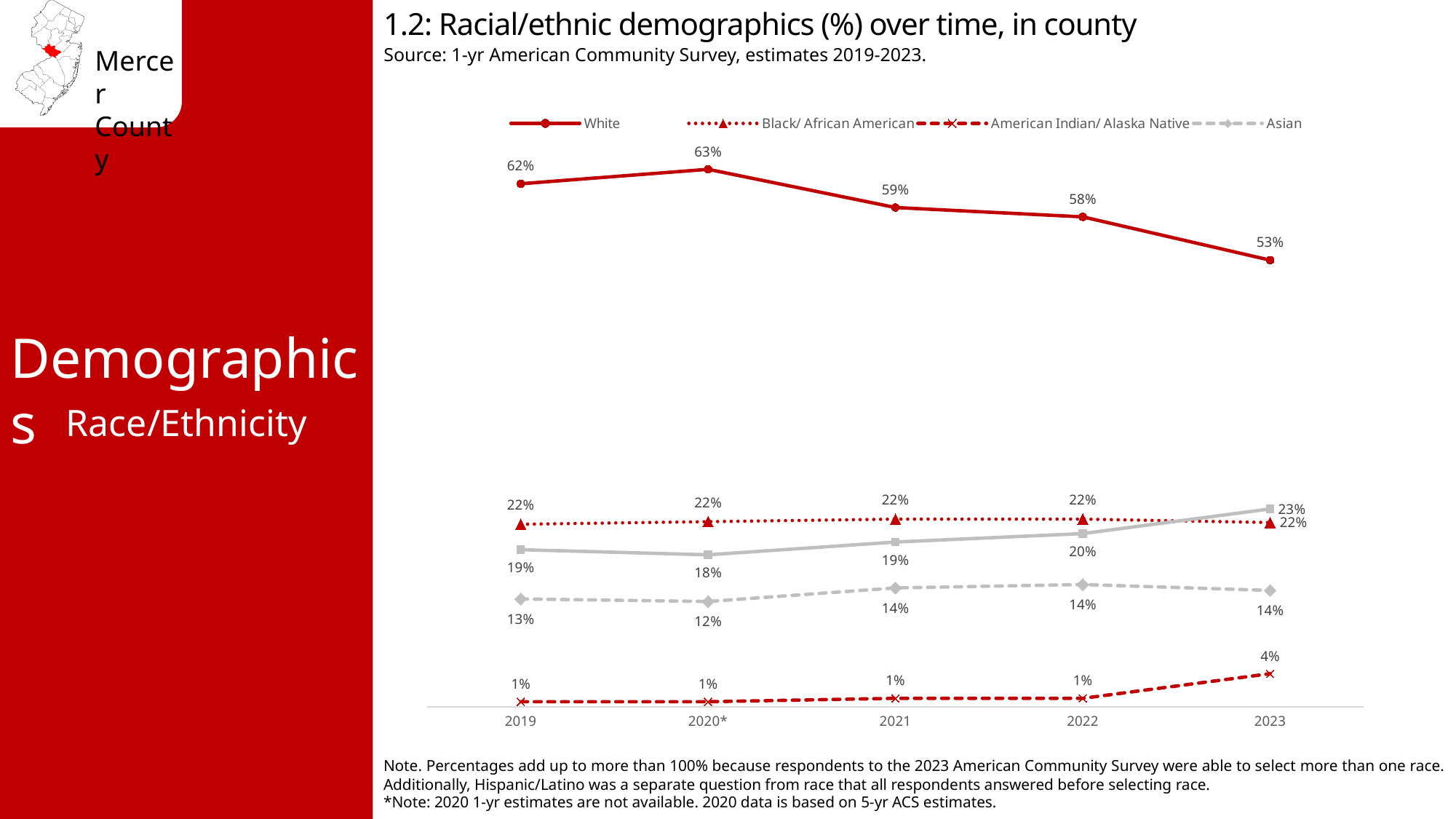
In which year is the White percentage highest? 2020* In which year is the White percentage lowest? 2023 What kind of chart is this? Line chart What is the value for American Indian/ Alaska Native in 2023? 4% How many years are shown on the x axis? 5 Does the White percentage rise or fall from 2020* to 2023? Fall What is the difference between the White percentage in 2019 and in 2023? 9 percentage points What is the value for Black/ African American in 2021? 22% What is the value for White in 2023? 53% What is the value for Asian in 2020*? 12% Which is larger in 2021, the Black/ African American value or the Asian value? Black/ African American What is the value for White in 2019? 62%